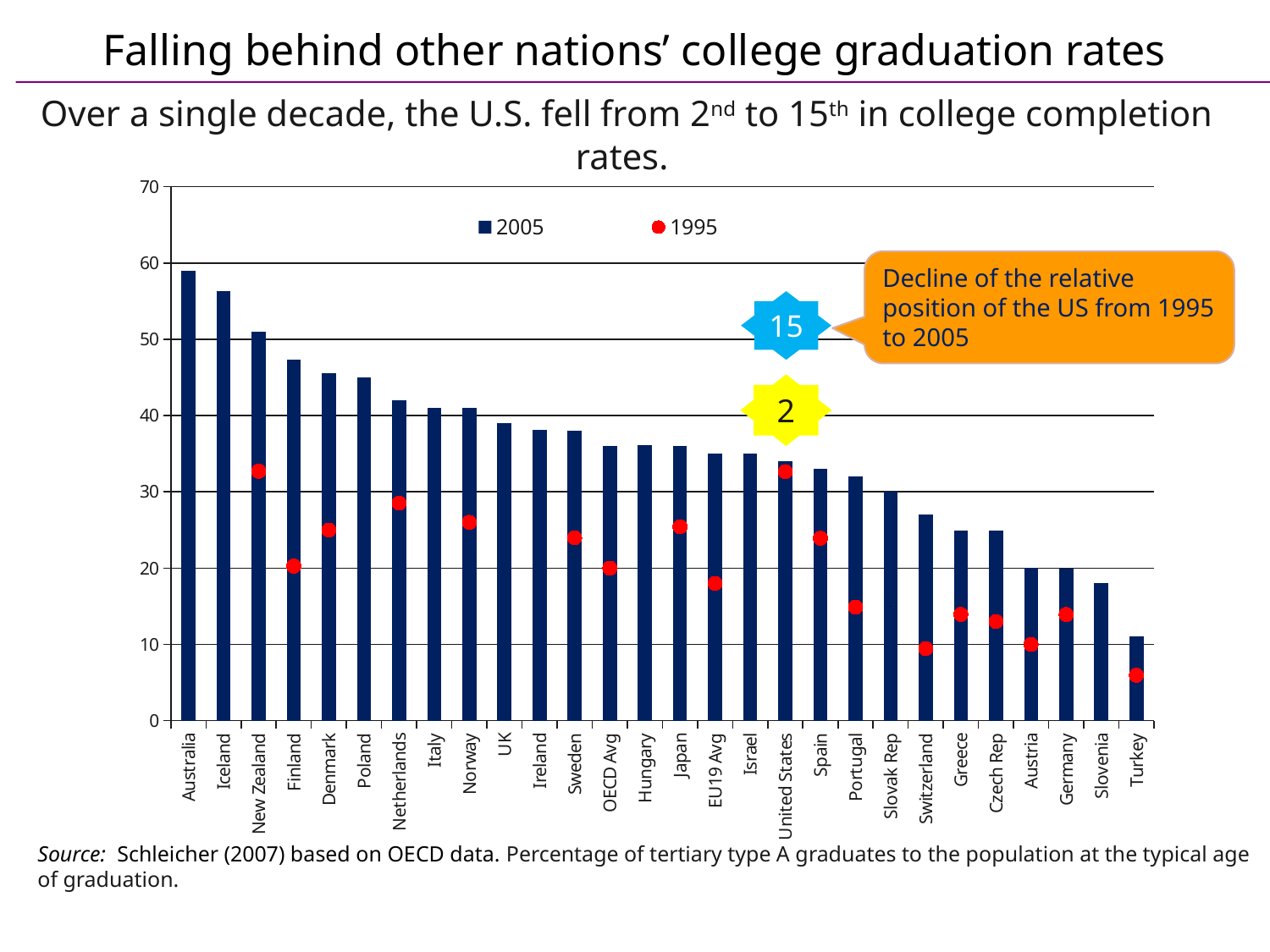
Do the 2005 values rise or fall from left to right along the x axis? fall Which has the larger 1995 value, New Zealand or Finland? New Zealand Which country has the highest 2005 value? Australia Is the 2005 value for Australia greater or less than 50? greater What kind of chart is shown on the slide? bar chart Is the 2005 value for Slovenia greater or less than 20? less How many countries or groups are shown on the x axis? 28 How many series does the legend list? 2 Which country has the lowest 2005 value? Turkey Is the 1995 value for Turkey greater or less than 10? less Which series is shown with red circle markers? 1995